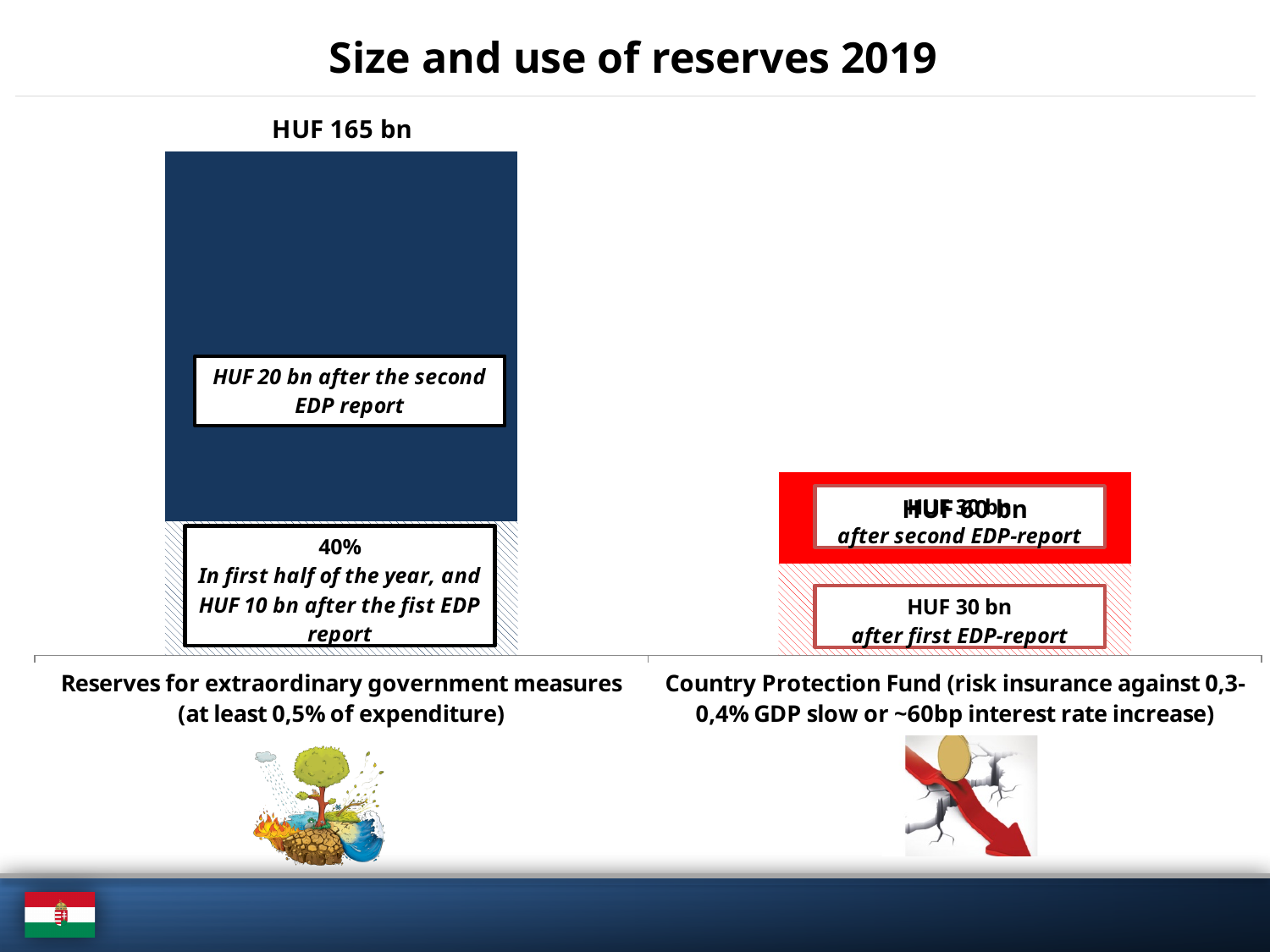
Which category has the highest value on the chart? Reserves for extraordinary government measures How many categories (bars) are shown on the chart? 2 What colour is the bar for the Country Protection Fund? red According to the label inside the Reserves for extraordinary government measures bar, how much is used after the second EDP report? HUF 20 bn What value is printed in the lower (hatched) segment of the Country Protection Fund bar? HUF 30 bn after first EDP-report According to the label in the lower segment of the Reserves for extraordinary government measures bar, how much is used after the first EDP report? HUF 10 bn What kind of chart is shown on the slide? bar chart What percentage is printed in the lower hatched segment of the Reserves for extraordinary government measures bar? 40% What total value is printed above the bar for Reserves for extraordinary government measures? HUF 165 bn What is the title of the slide containing the chart? Size and use of reserves 2019 Which category has the taller bar, Reserves for extraordinary government measures or Country Protection Fund? Reserves for extraordinary government measures